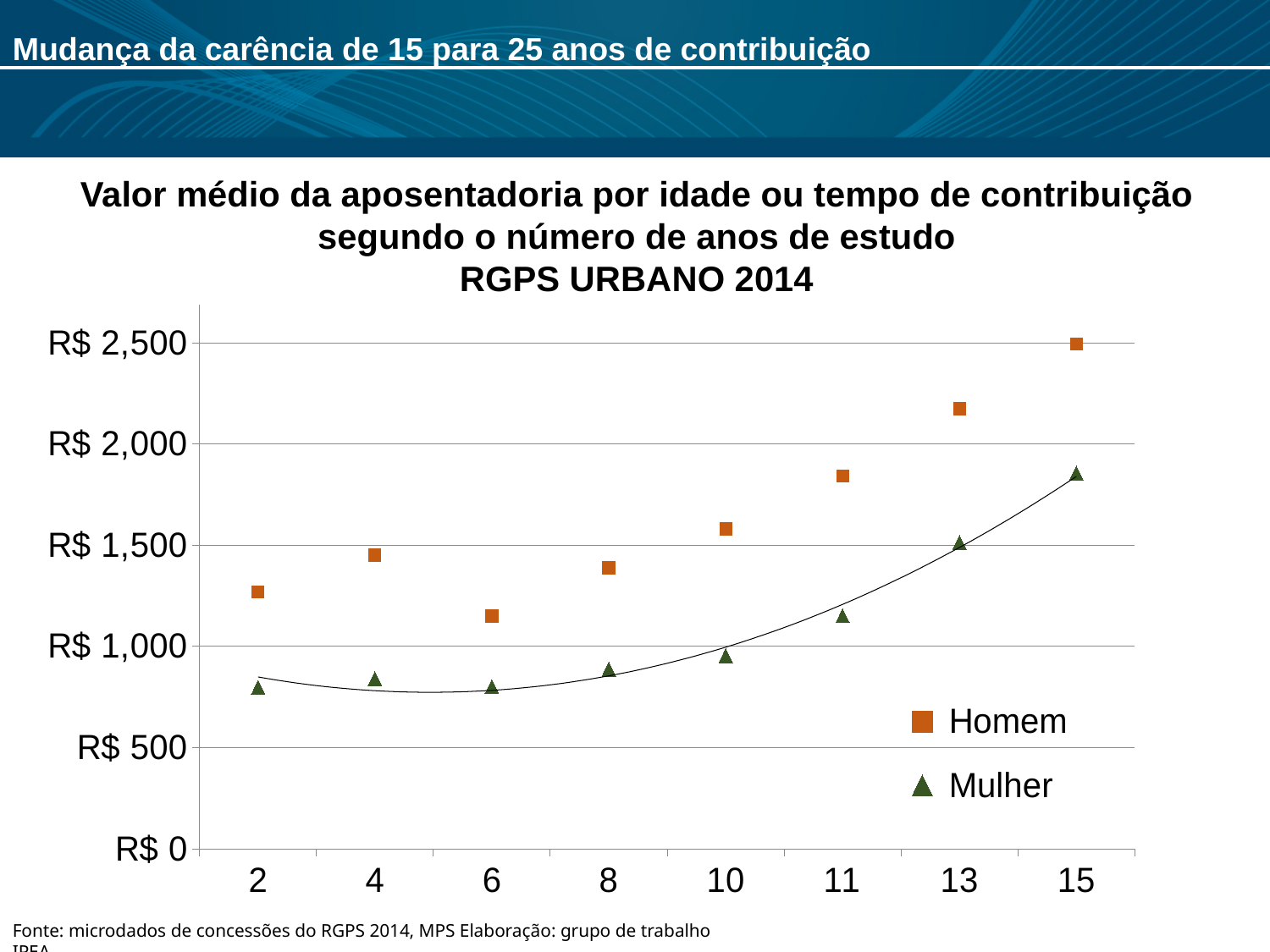
For the Homem series, at which number of years of study is the value highest? 15 How many x-axis categories (years of study) are plotted? 8 Which marker shape is used for the Mulher series? triangle For the Mulher series, at which number of years of study is the value highest? 15 Do the Mulher values generally rise or fall as the number of years of study increases from 6 to 15? rise For the Homem series, at which number of years of study is the value lowest? 6 How many series does the legend list? 2 Is the Mulher value at 10 years of study greater or less than R$ 1,000? less Is the Homem value at 6 years of study greater or less than R$ 1,000? greater Is the Homem value at 13 years of study greater or less than R$ 2,000? greater What kind of chart is shown on the slide? scatter chart At 11 years of study, which series has the larger value, Homem or Mulher? Homem